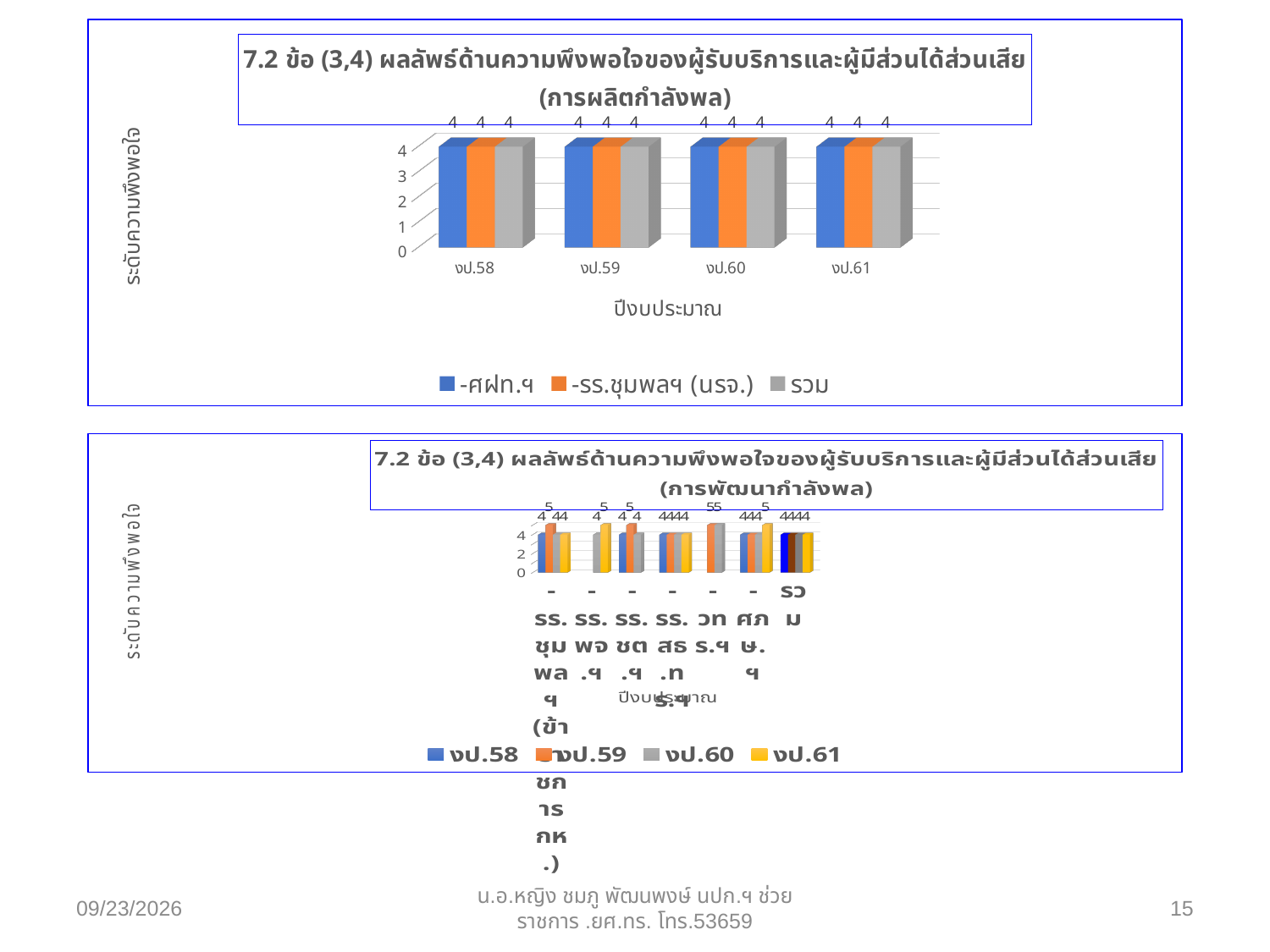
In the top chart (การผลิตกำลังพล), what is the value for -รร.ชุมพลฯ (นรจ.) in งป.60? 4 In the bottom chart (การพัฒนากำลังพล), how many series does the legend list? 4 What kind of chart is the top chart (การผลิตกำลังพล)? bar chart In the top chart (การผลิตกำลังพล), which colour represents the series รวม? grey In the top chart (การผลิตกำลังพล), what is the value for -ศฝท.ฯ in งป.58? 4 In the top chart (การผลิตกำลังพล), how many fiscal-year categories are shown on the x axis? 4 In the top chart (การผลิตกำลังพล), how many series does the legend list? 3 In the top chart (การผลิตกำลังพล), what is the label of the x axis? ปีงบประมาณ What kind of chart is the bottom chart (การพัฒนากำลังพล)? bar chart In the top chart (การผลิตกำลังพล), do the values for รวม rise, fall, or stay the same from งป.58 to งป.61? stay the same In the top chart (การผลิตกำลังพล), what is the value for รวม in งป.61? 4 In the top chart (การผลิตกำลังพล), what is the difference between the -ศฝท.ฯ value in งป.59 and the รวม value in งป.59? 0